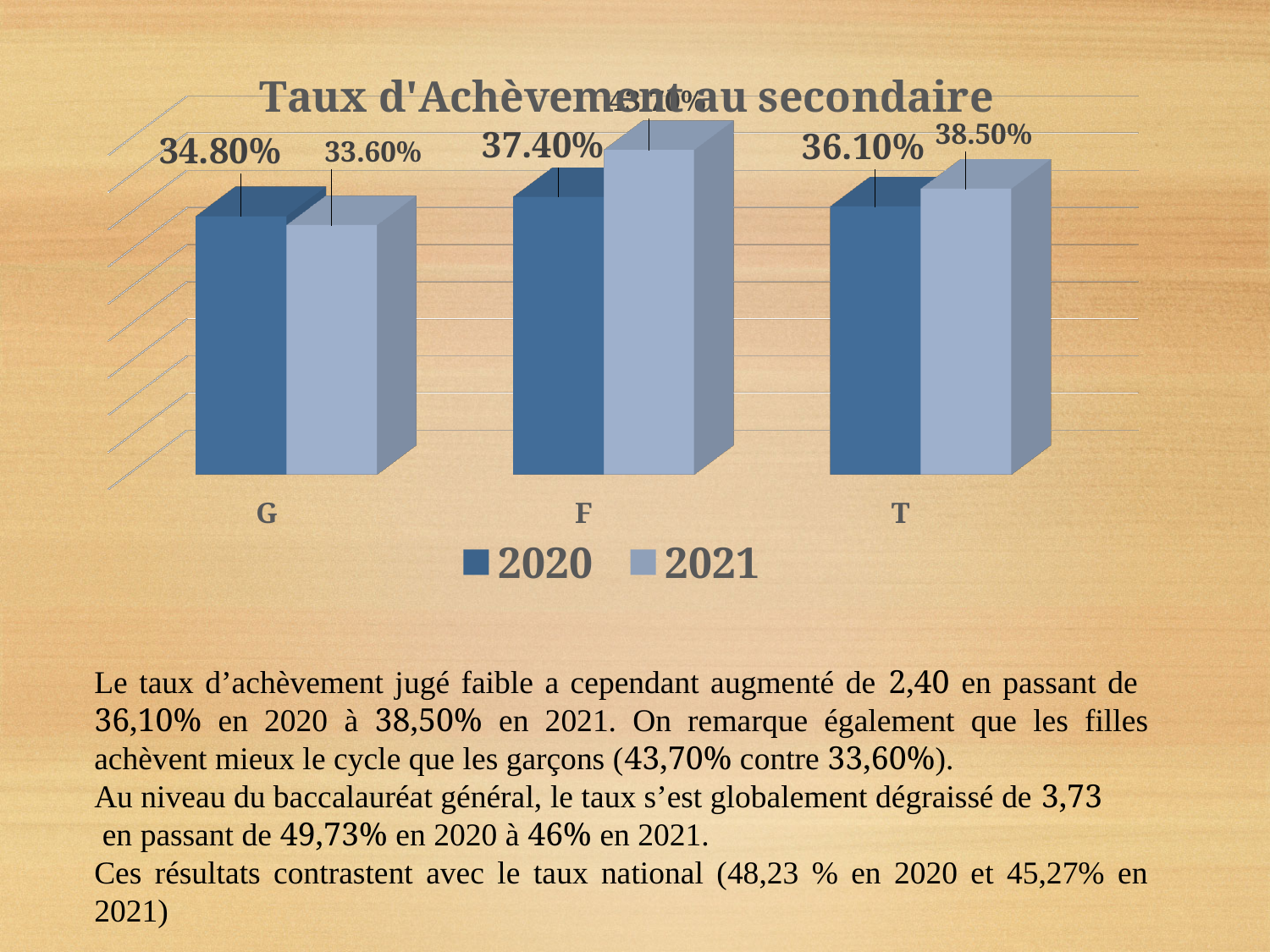
What is the title of the chart? Taux d'Achèvement au secondaire What is the difference between the 2021 and 2020 values for T? 2.40 percentage points What is the value for G in the 2020 series? 34.80% How many categories are shown on the x axis? 3 Which category has the highest value in the 2021 series? F For G, which series has the larger value, 2020 or 2021? 2020 What is the value for T in the 2021 series? 38.50% Which category has the lowest value in the 2020 series? G What is the value for G in the 2021 series? 33.60% How many series does the legend list? 2 What is the value for T in the 2020 series? 36.10% What is the value for F in the 2020 series? 37.40%